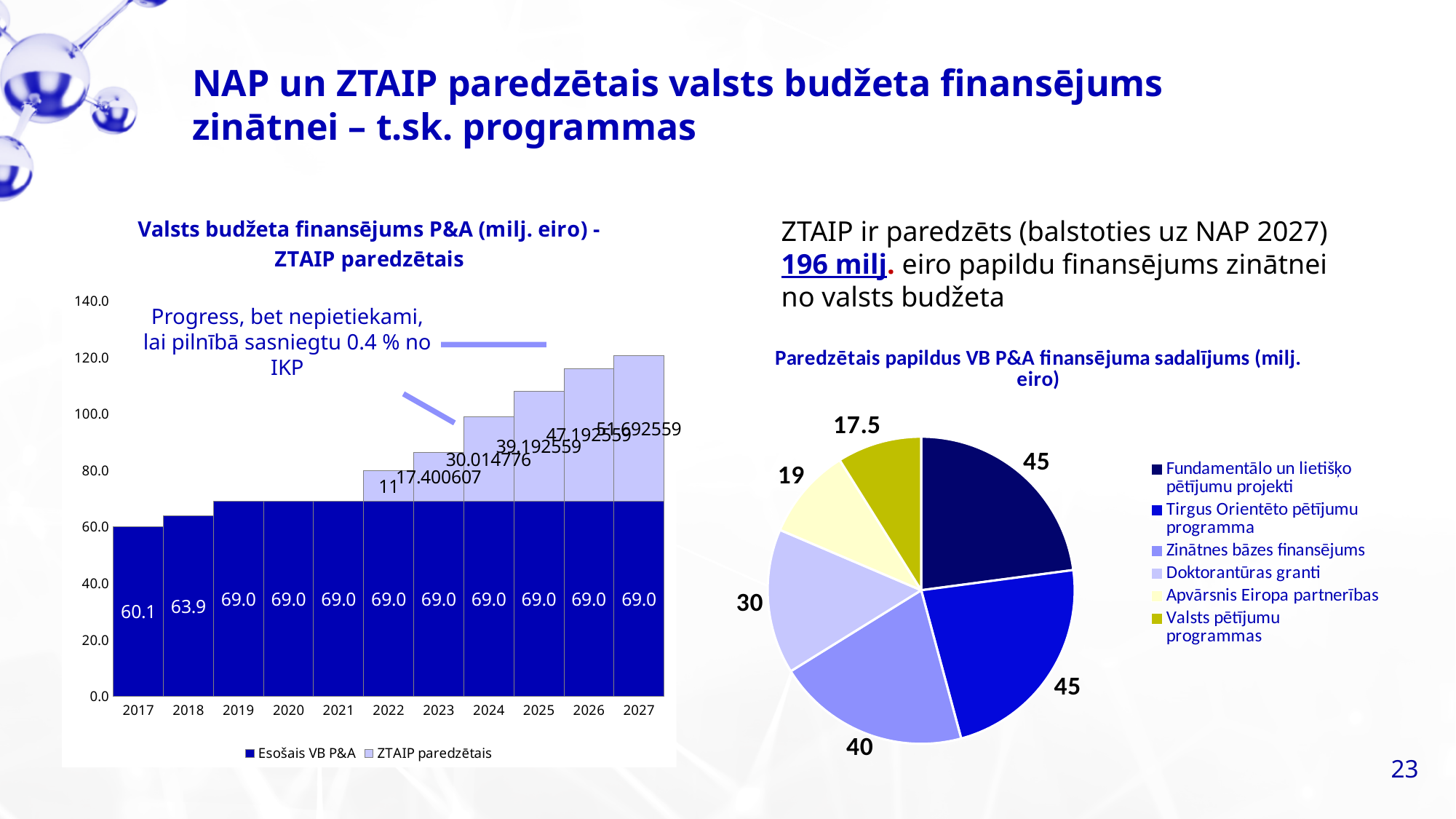
In the pie chart 'Paredzētais papildus VB P&A finansējuma sadalījums (milj. eiro)', what is the value for 'Doktorantūras granti'? 30 In the left bar chart, what is the value of 'ZTAIP paredzētais' for 2022? 11 In the left bar chart, what is the value of 'Esošais VB P&A' for 2017? 60.1 In the pie chart 'Paredzētais papildus VB P&A finansējuma sadalījums (milj. eiro)', how many slices are there? 6 In the left bar chart, how many years are shown on the x axis? 11 In the left bar chart, what is the difference between the 'Esošais VB P&A' values for 2018 and 2017? 3.8 In the pie chart 'Paredzētais papildus VB P&A finansējuma sadalījums (milj. eiro)', which is larger: 'Apvārsnis Eiropa partnerības' or 'Valsts pētījumu programmas'? Apvārsnis Eiropa partnerības In the pie chart 'Paredzētais papildus VB P&A finansējuma sadalījums (milj. eiro)', which category has the smallest value? Valsts pētījumu programmas In the left bar chart, what is the value of 'ZTAIP paredzētais' for 2027? 51.692559 What kind of chart is the left chart titled 'Valsts budžeta finansējums P&A (milj. eiro) - ZTAIP paredzētais'? bar chart In the left bar chart, does the 'ZTAIP paredzētais' series rise or fall from 2022 to 2027? rise In the left bar chart, how many series does the legend list? 2